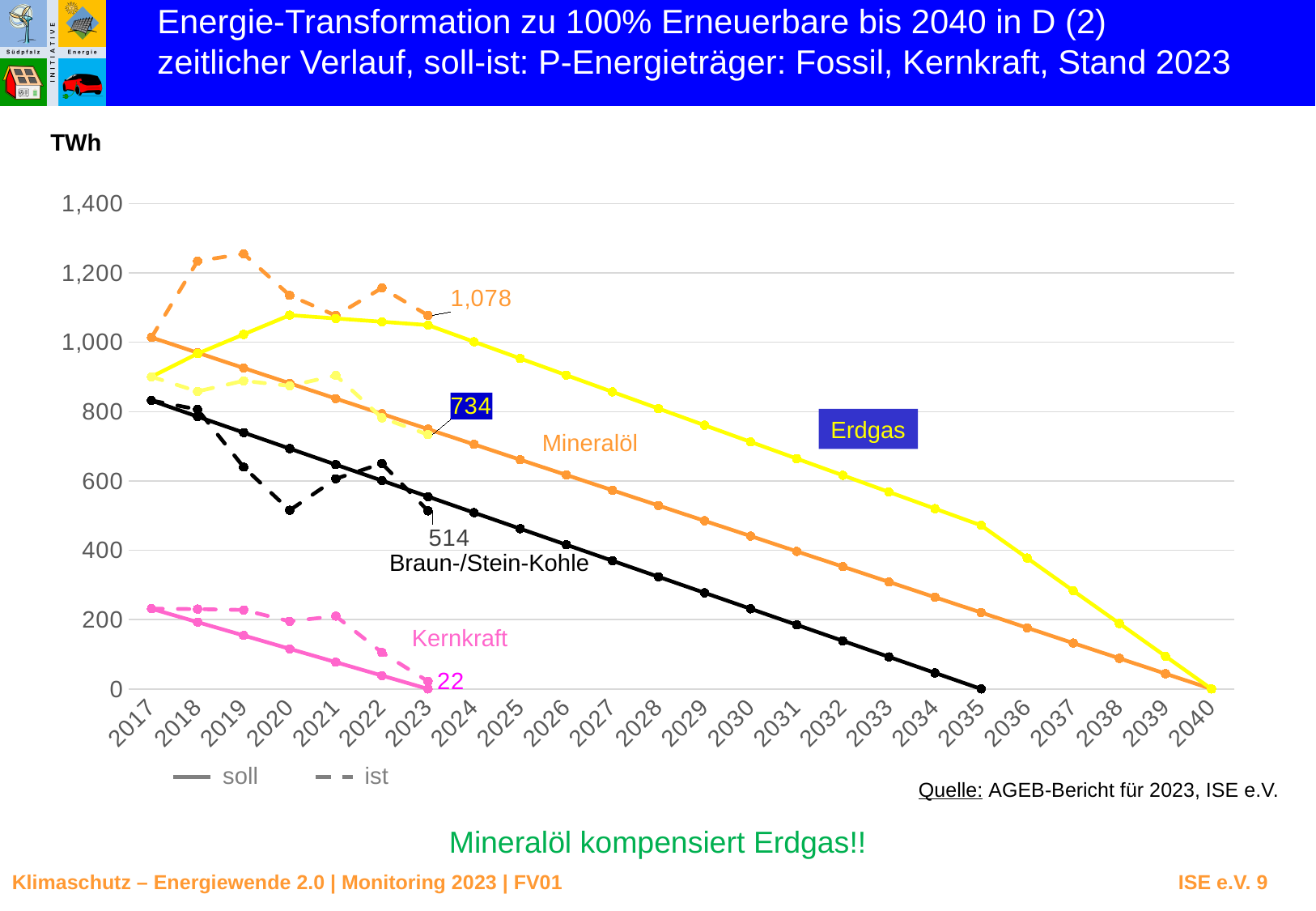
What kind of chart is shown on the slide? line chart What is the difference between the 2023 'ist' values of Mineralöl (1,078) and Erdgas (734)? 344 Is the 'soll' value for Erdgas in 2030 greater or less than 800? less Which energy source has the lowest labelled 'ist' value in 2023? Kernkraft Which energy source has the highest labelled 'ist' value in 2023? Mineralöl What is the labelled 'ist' value for Kernkraft in 2023? 22 What is the labelled 'ist' value for Mineralöl in 2023? 1,078 How many entries does the legend list? 2 What is the labelled 'ist' value for Erdgas in 2023? 734 How many years are shown on the x axis? 24 Does the 'soll' line for Braun-/Stein-Kohle rise or fall from 2017 to 2035? fall What is the labelled 'ist' value for Braun-/Stein-Kohle in 2023? 514